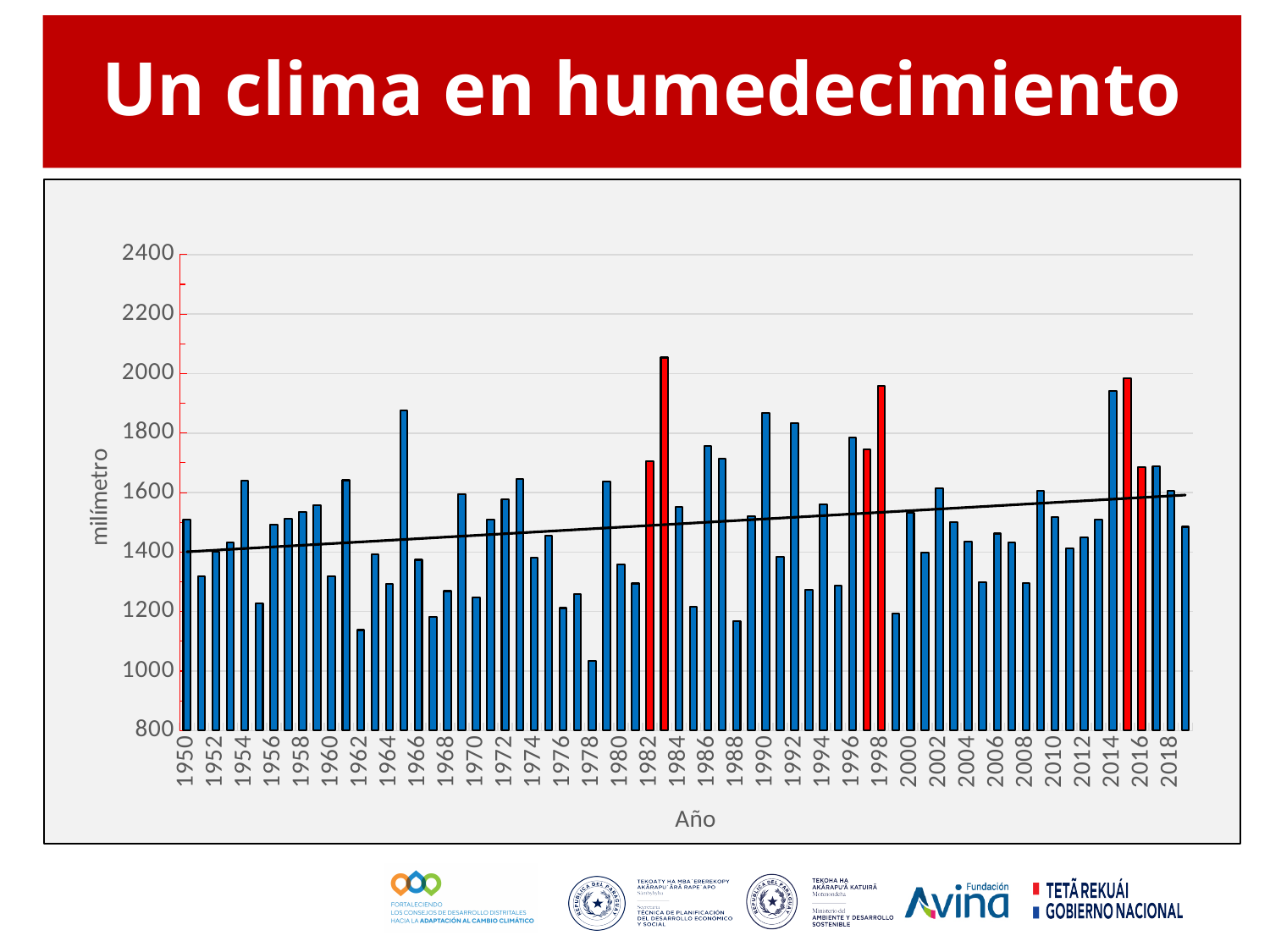
What is the title of the slide containing the chart? Un clima en humedecimiento What is the label of the vertical axis of the chart? milímetro Is the value for 1983 greater or less than 2000? greater Is the value for 2014 greater or less than 1800? greater Is the value for 1978 greater or less than 1200? less Which year has the lowest bar in the chart? 1978 Which year has the highest bar in the chart? 1983 What kind of chart is shown on the slide? bar chart Does the trend line drawn across the chart rise or fall from 1950 to 2019? rise Which year has the larger value, 1983 or 1998? 1983